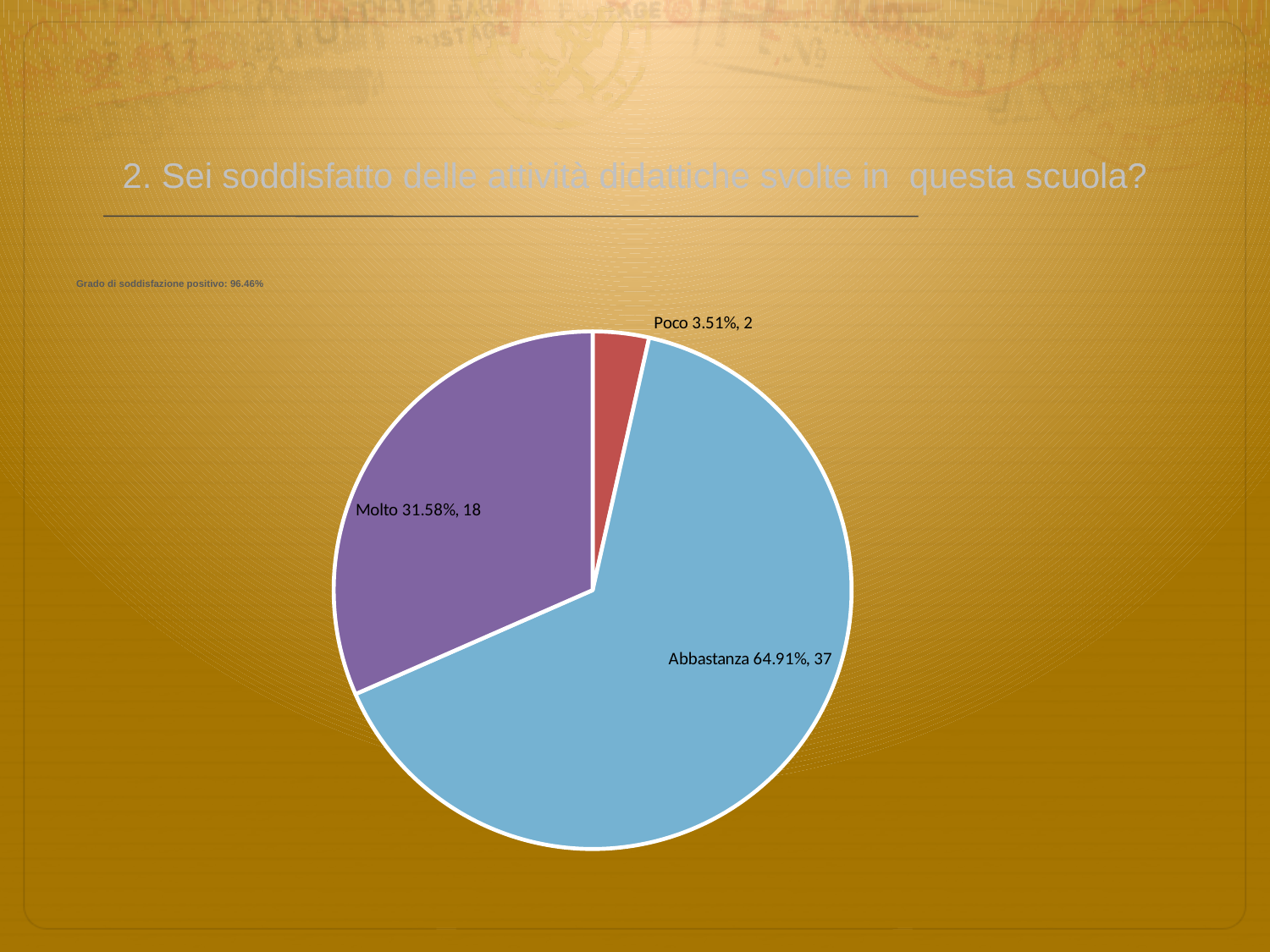
How many responses does the Molto slice represent? 18 How many responses does the Abbastanza slice represent? 37 Which category has the largest slice? Abbastanza Which has more responses, Molto or Poco? Molto What kind of chart is shown on the slide? pie chart What is the difference in number of responses between Abbastanza and Molto? 19 How many slices does the pie chart have? 3 How many responses does the Poco slice represent? 2 What percentage share does the Abbastanza slice have? 64.91% Which category has the smallest slice? Poco What percentage share does the Molto slice have? 31.58% What percentage share does the Poco slice have? 3.51%